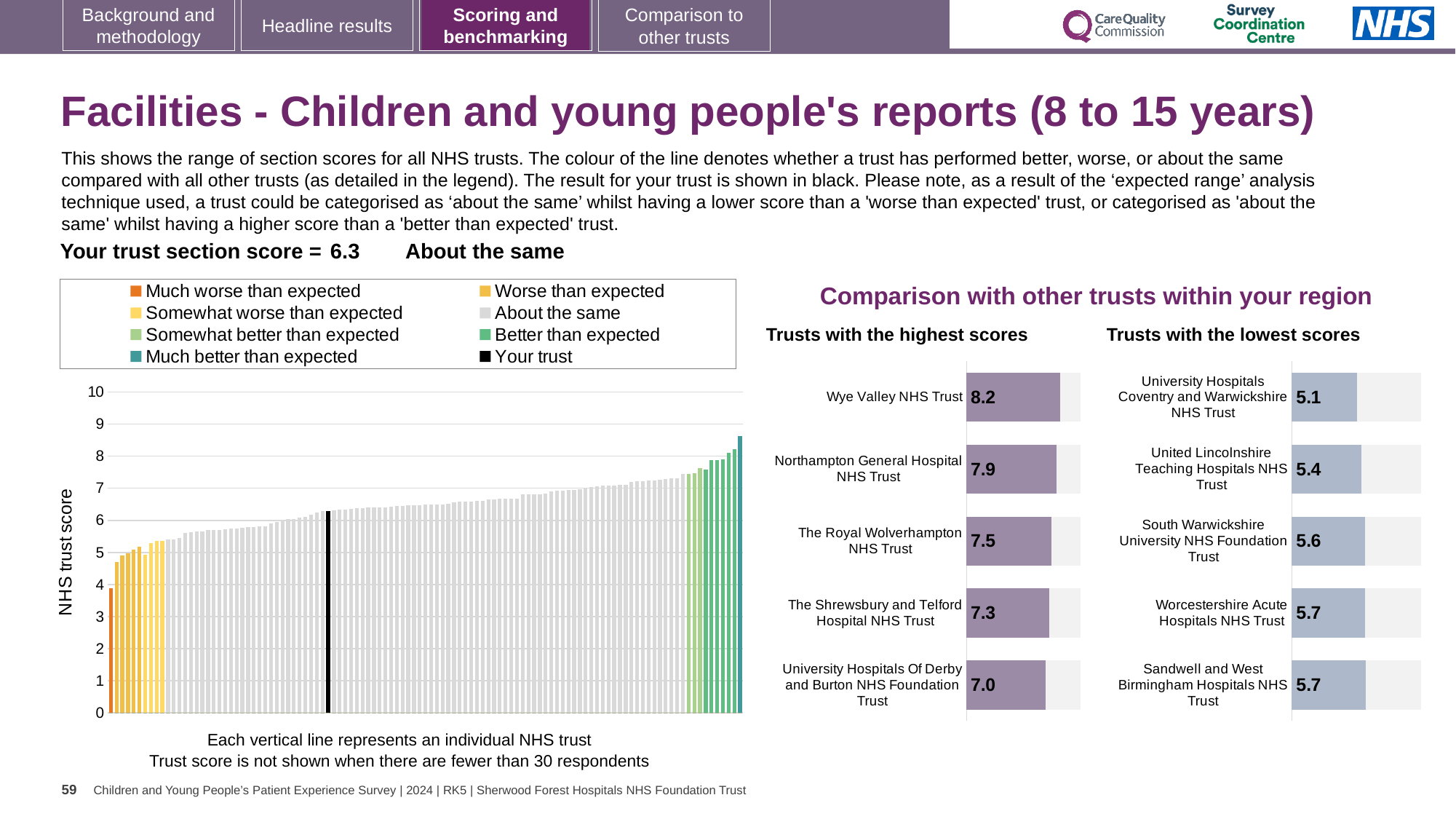
In the 'Trusts with the lowest scores' chart, what is the difference between the scores of South Warwickshire University NHS Foundation Trust and University Hospitals Coventry and Warwickshire NHS Trust? 0.5 In the large chart on the left, do the trust scores rise or fall from left to right? Rise In the 'Trusts with the highest scores' chart, what is the score for Wye Valley NHS Trust? 8.2 In the 'Trusts with the highest scores' chart, what is the score for The Shrewsbury and Telford Hospital NHS Trust? 7.3 How many trusts are shown in the 'Trusts with the lowest scores' chart? 5 In the 'Trusts with the highest scores' chart, what is the difference between the scores of Wye Valley NHS Trust and University Hospitals Of Derby and Burton NHS Foundation Trust? 1.2 In the 'Trusts with the highest scores' chart, which trust has the highest score? Wye Valley NHS Trust In the 'Trusts with the lowest scores' chart, which trust has the lowest score? University Hospitals Coventry and Warwickshire NHS Trust In the 'Trusts with the lowest scores' chart, what is the score for United Lincolnshire Teaching Hospitals NHS Trust? 5.4 How many entries does the legend of the large chart on the left list? 8 What kind of chart is the large chart on the left showing NHS trust scores? Bar chart Which is larger: the score for Northampton General Hospital NHS Trust in the highest scores chart or the score for Worcestershire Acute Hospitals NHS Trust in the lowest scores chart? Northampton General Hospital NHS Trust